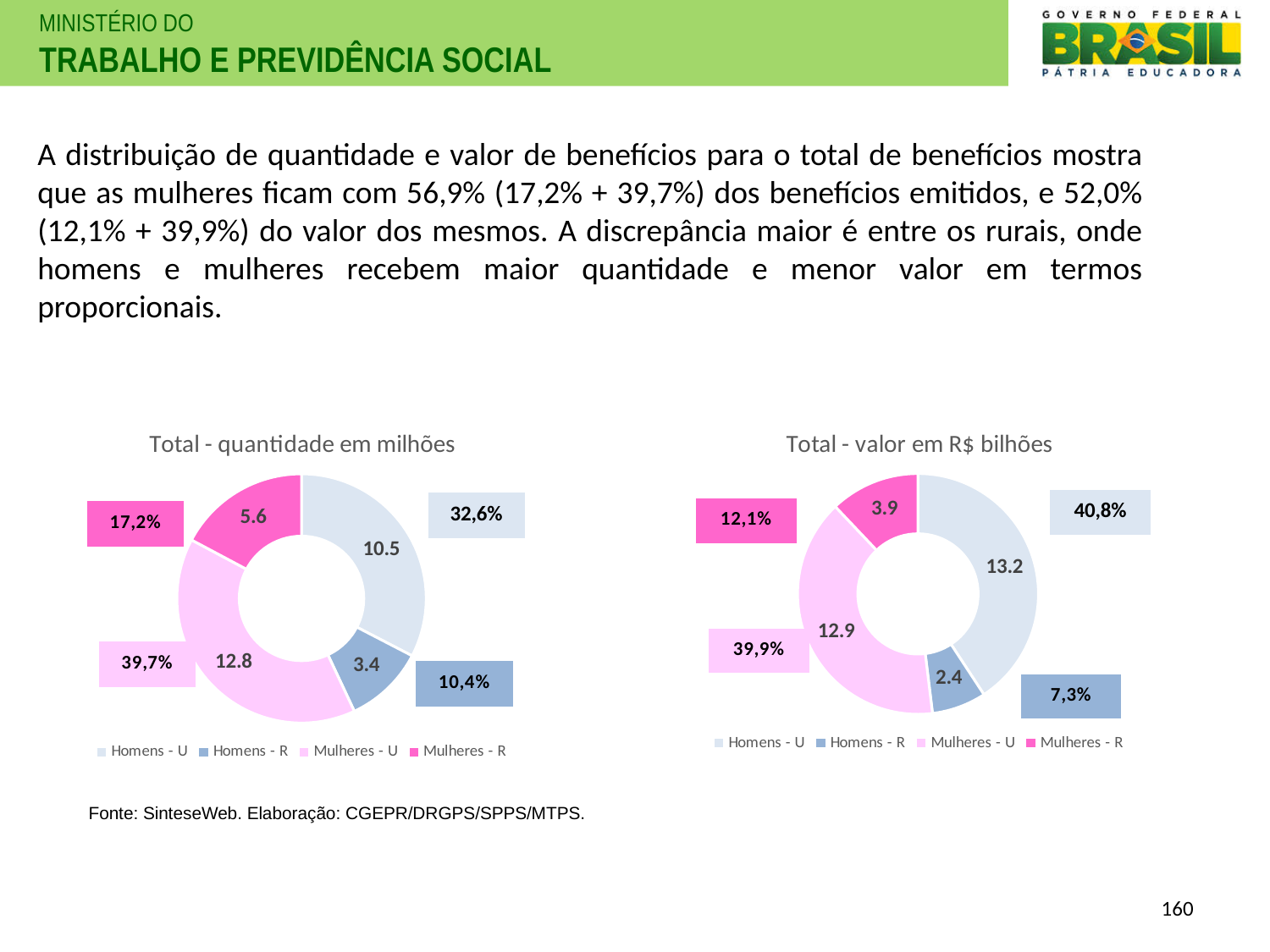
In the chart titled "Total - quantidade em milhões", what share of the total does Mulheres - R represent? 17,2% In the chart titled "Total - quantidade em milhões", what is the difference between the values for Homens - U and Homens - R? 7.1 In the chart titled "Total - valor em R$ bilhões", which is larger, the value for Homens - U or Mulheres - R? Homens - U In the chart titled "Total - quantidade em milhões", what is the value for Mulheres - U? 12.8 In the chart titled "Total - quantidade em milhões", which category has the highest value? Mulheres - U In the chart titled "Total - valor em R$ bilhões", what is the value for Homens - R? 2.4 What are the legend entries of the chart titled "Total - quantidade em milhões"? Homens - U, Homens - R, Mulheres - U, Mulheres - R How many categories does the chart titled "Total - quantidade em milhões" show? 4 In the chart titled "Total - valor em R$ bilhões", what is the total of the values for Mulheres - U and Mulheres - R? 16.8 What kind of chart is the chart titled "Total - valor em R$ bilhões"? doughnut (pie) chart In the chart titled "Total - valor em R$ bilhões", which category has the lowest value? Homens - R In the chart titled "Total - valor em R$ bilhões", what share of the total does Homens - U represent? 40,8%